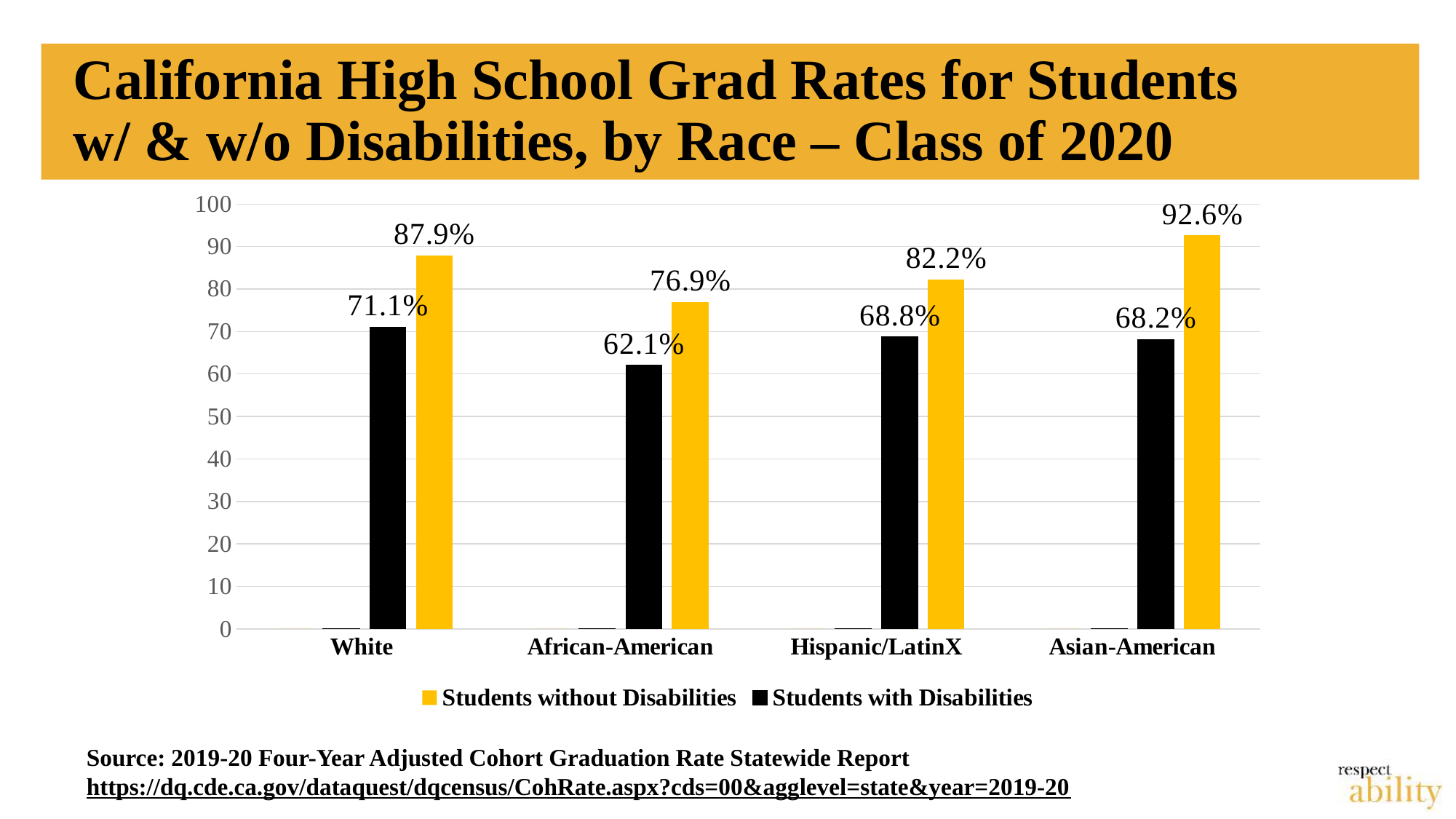
What is the difference between the graduation rates of White students with disabilities and African-American students with disabilities? 9 percentage points Which racial group has the lowest graduation rate for students with disabilities? African-American What is the graduation rate for White students without disabilities? 87.9% Which is larger: the graduation rate for White students with disabilities or for Hispanic/LatinX students with disabilities? White students with disabilities What is the graduation rate for Hispanic/LatinX students without disabilities? 82.2% What type of chart is shown on the slide? Bar chart How many series does the chart's legend list? 2 What is the graduation rate for Asian-American students with disabilities? 68.2% Which racial group has the highest graduation rate for students without disabilities? Asian-American What is the difference between the graduation rates of Asian-American students without disabilities and Asian-American students with disabilities? 24.4 percentage points What is the graduation rate for African-American students with disabilities? 62.1% How many racial groups are shown on the x axis of the chart? 4